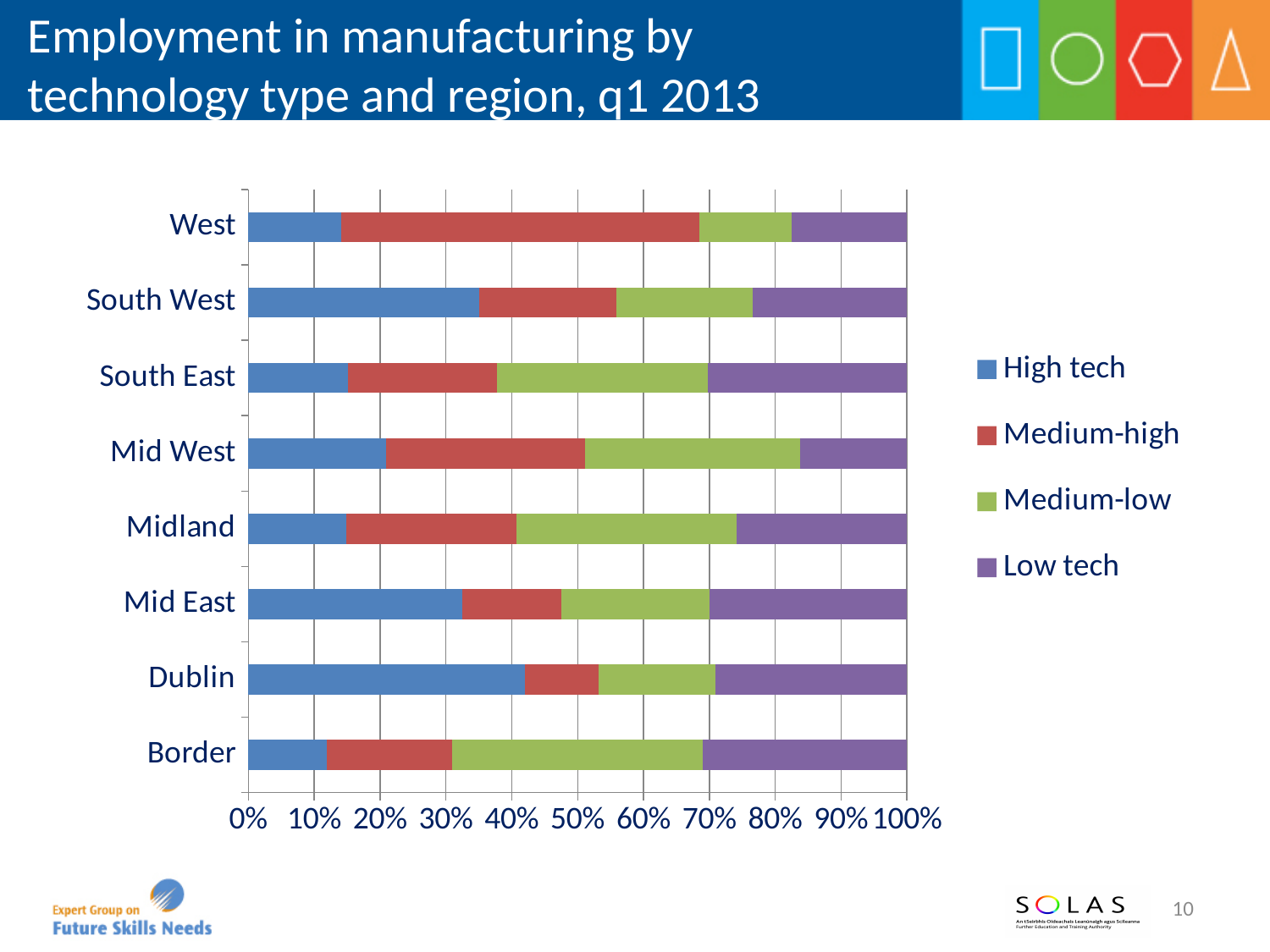
Which region has the largest Medium-low share? Border Which is larger, the Medium-high share for West or for South West? West How many series does the legend list? 4 Is the High tech share for Dublin greater or less than 30%? greater Which region has the largest High tech share? Dublin Which region has the largest Medium-high share? West Which series is shown in purple in the legend? Low tech Which is larger, the High tech share for Dublin or for Border? Dublin How many regions are shown on the chart? 8 Is the High tech share for Border greater or less than 20%? less What kind of chart is shown on the slide? Stacked bar chart Is the High tech share for West greater or less than 20%? less